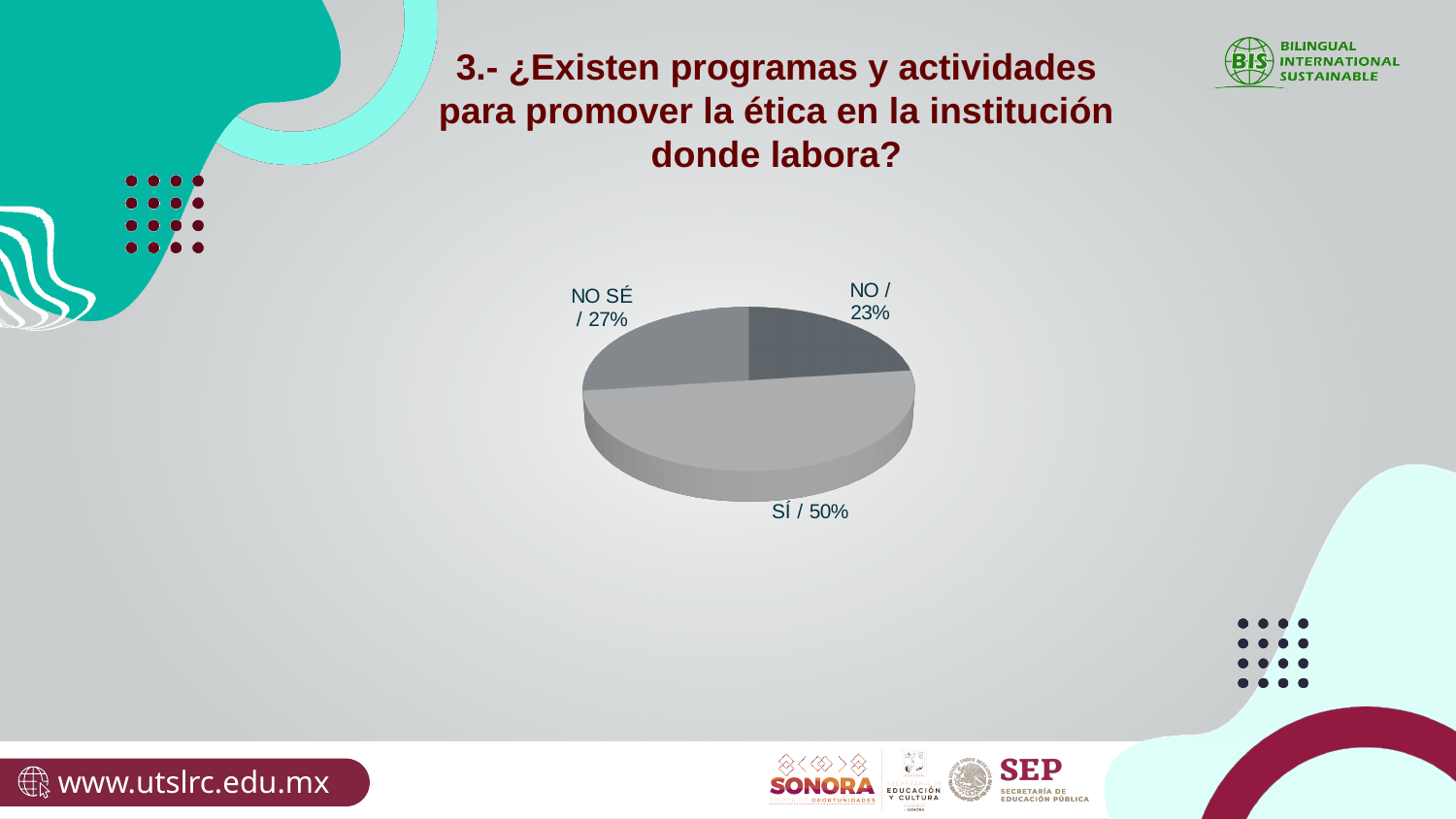
Which slice is larger, NO SÉ or NO? NO SÉ How many slices does the pie chart have? 3 Which response has the smallest share of the pie? NO Which response has the largest share of the pie? SÍ What percentage of respondents answered NO? 23% What is the difference in percentage points between the SÍ and NO slices? 27 What share of the pie does the SÍ slice represent? 50% What percentage of respondents answered NO SÉ? 27% What question does the slide title ask about the chart? 3.- ¿Existen programas y actividades para promover la ética en la institución donde labora? What kind of chart is shown on the slide? pie chart What is the difference in percentage points between the NO SÉ and NO slices? 4 What percentage of respondents answered SÍ? 50%